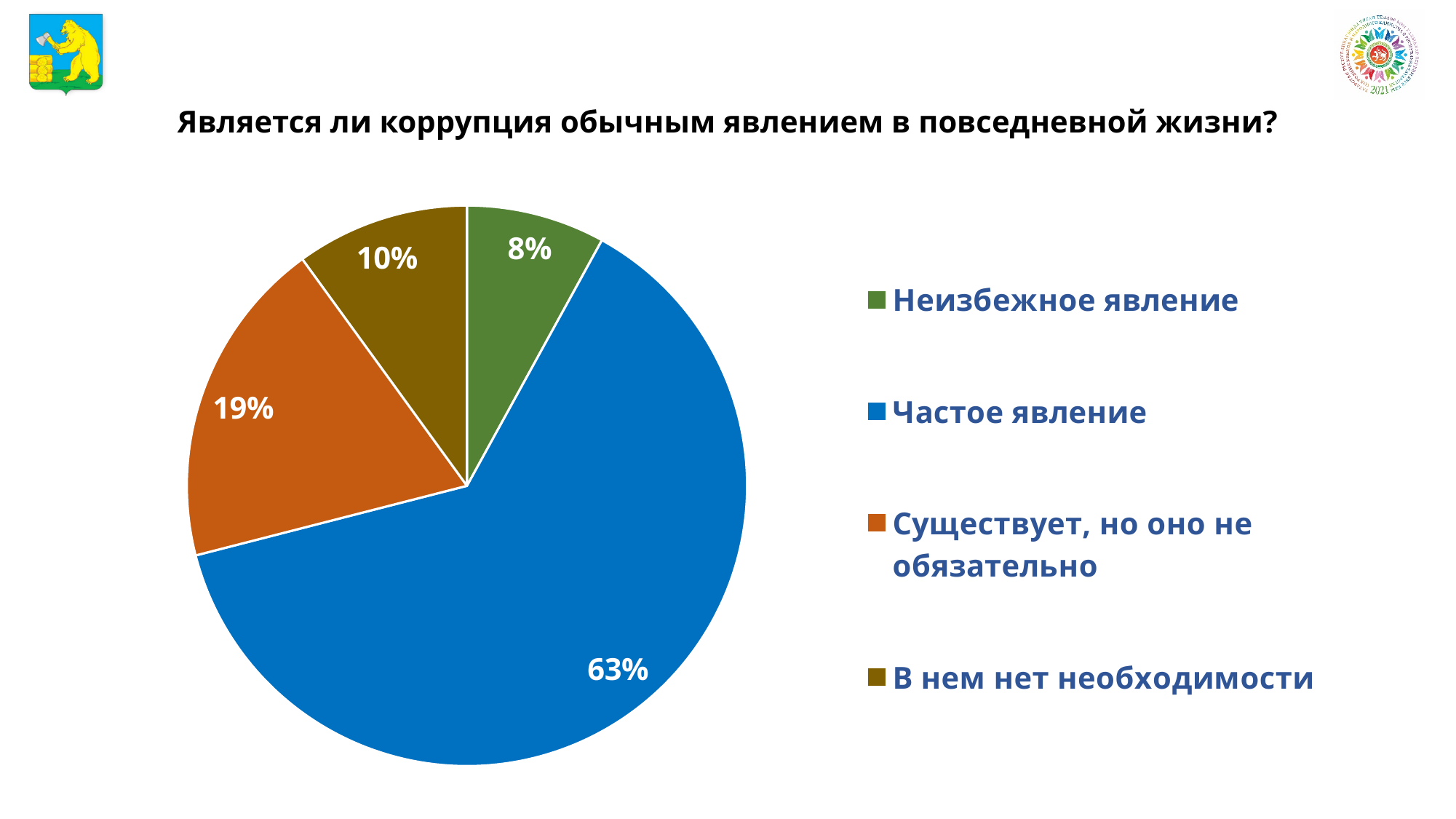
What share of the pie does "Неизбежное явление" have? 8% What share of the pie does "В нем нет необходимости" have? 10% Which is larger: the slice for "В нем нет необходимости" or the slice for "Неизбежное явление"? В нем нет необходимости What type of chart is shown on the slide? pie chart What colour is the slice for "Существует, но оно не обязательно"? orange Which category has the smallest slice of the pie? Неизбежное явление What share of the pie does "Частое явление" have? 63% How many categories does the pie chart have? 4 What share of the pie does "Существует, но оно не обязательно" have? 19% Which category has the largest slice of the pie? Частое явление What is the title of the chart? Является ли коррупция обычным явлением в повседневной жизни? What is the difference in percentage points between "Частое явление" and "Существует, но оно не обязательно"? 44